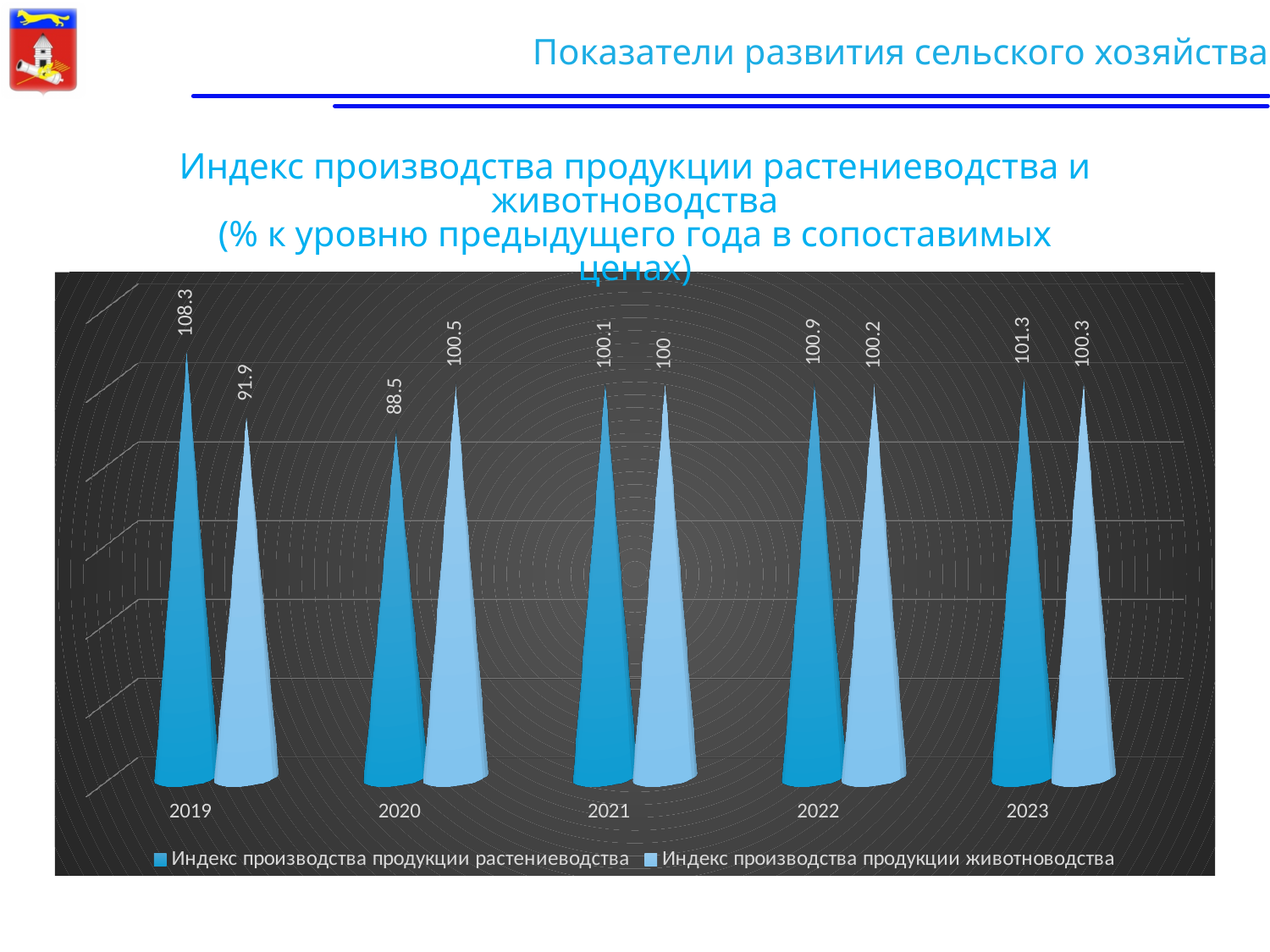
What kind of chart is shown on the slide? Bar chart What is the difference between the crop production index and the livestock production index in 2019? 16.4 What is the value of the crop production index for 2023? 101.3 How many series does the chart legend list? 2 Which is larger in 2020: the crop production index or the livestock production index? Индекс производства продукции животноводства What is the value of the crop production index (Индекс производства продукции растениеводства) for 2019? 108.3 In which year is the livestock production index the lowest? 2019 In which year is the crop production index the lowest? 2020 In which year is the crop production index the highest? 2019 What is the value of the livestock production index for 2021? 100 What is the value of the livestock production index (Индекс производства продукции животноводства) for 2020? 100.5 How many years are shown on the x axis of the chart? 5